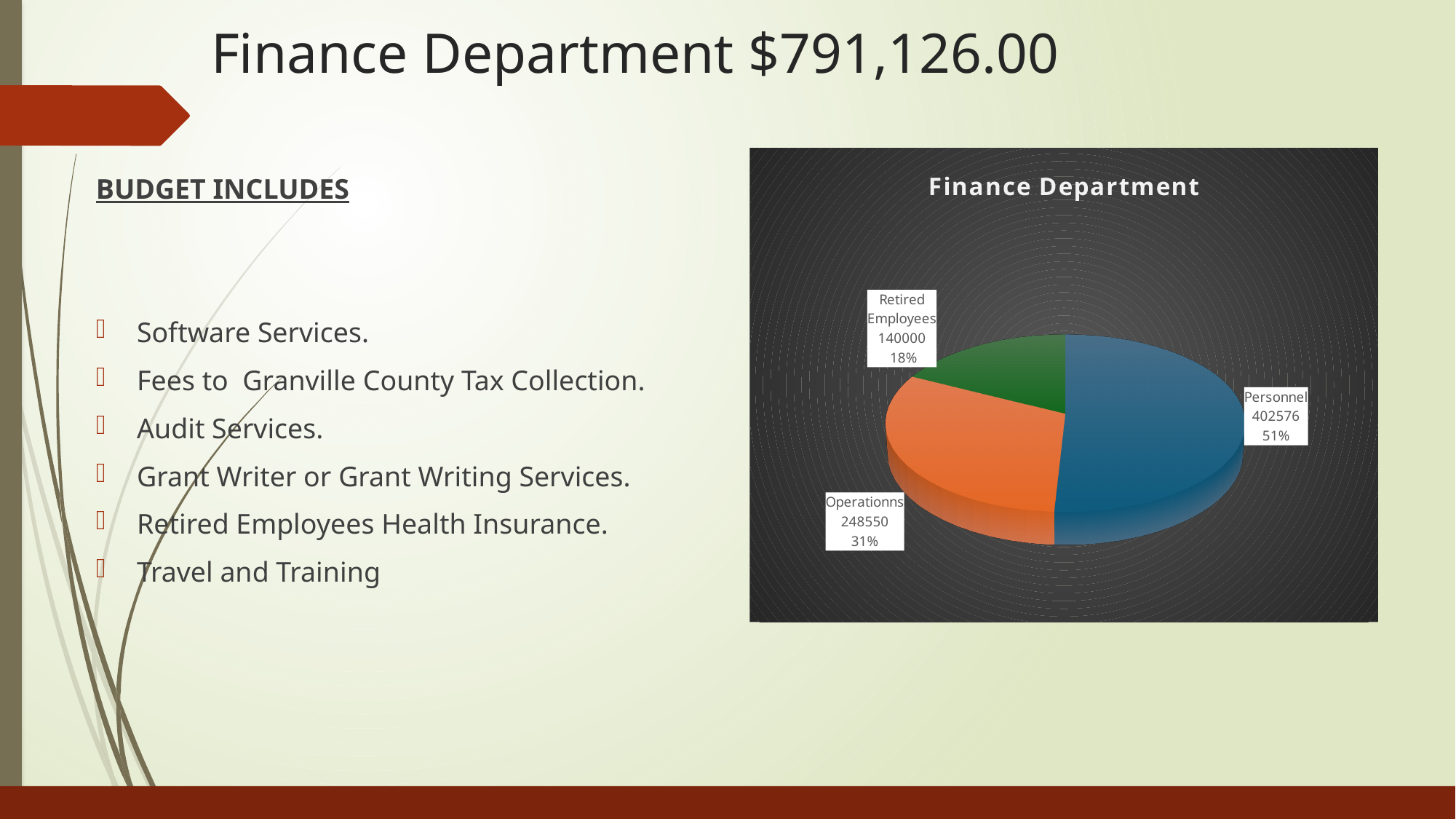
What is the value for Personnel? 402576 What type of chart is shown on the slide? pie chart What is the value for Retired Employees? 140000 What is the value for Operationns? 248550 What share of the pie does Operationns represent? 31% What share of the pie does Retired Employees represent? 18% How many slices does the pie chart have? 3 What is the difference between the Personnel and Operationns values? 154026 Which is larger, Operationns or Retired Employees? Operationns What is the title of the chart? Finance Department Which category has the smallest slice? Retired Employees Which category has the largest slice? Personnel